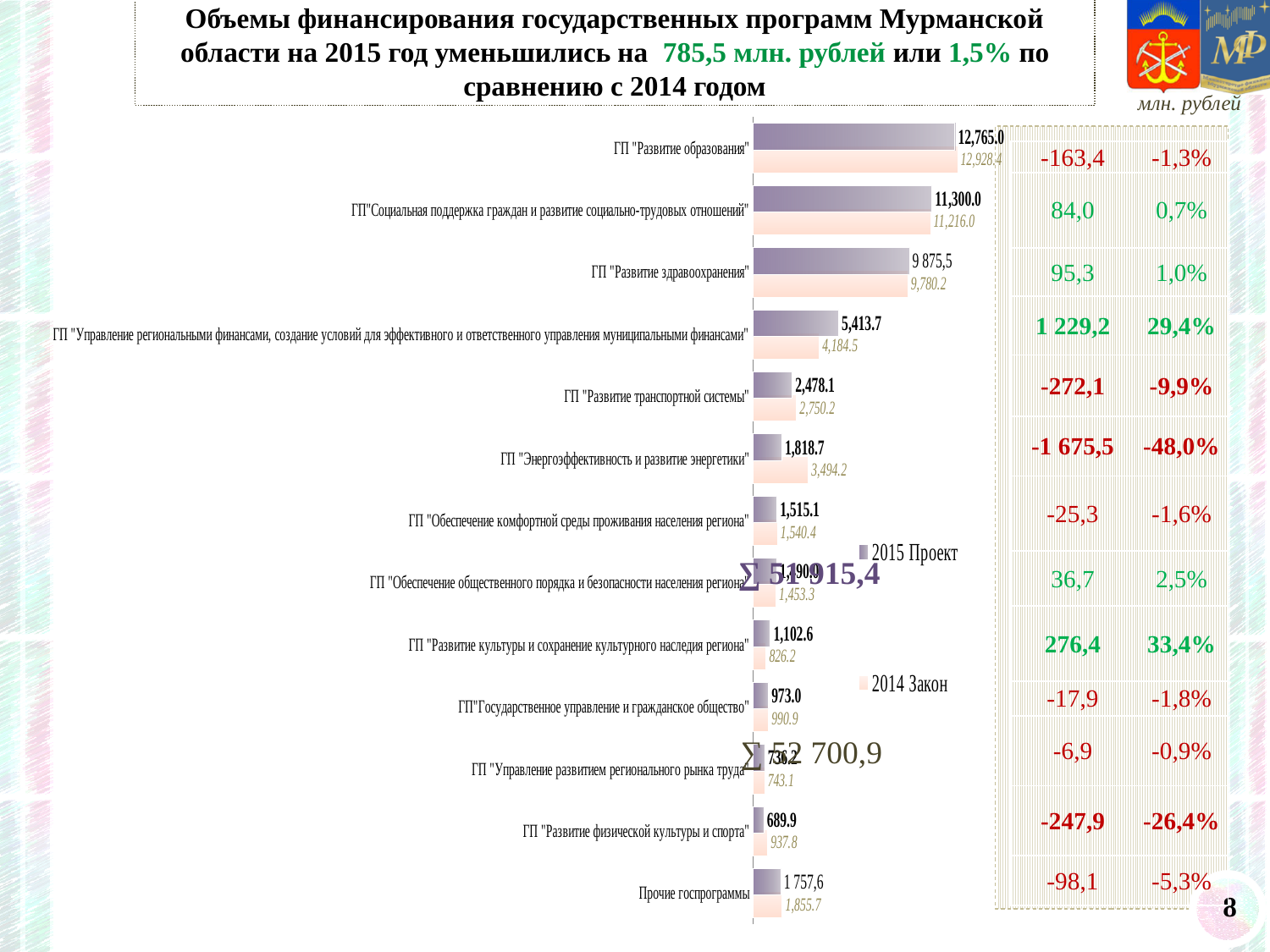
How many series does the chart legend list? 2 Which program has the highest 2015 Проект value? ГП "Развитие образования" What is the 2014 Закон value for ГП "Развитие здравоохранения"? 9,780.2 Which program has the lowest 2015 Проект value? ГП "Развитие физической культуры и спорта" What is the difference between the 2014 Закон and 2015 Проект values for ГП "Развитие образования"? 163.4 What is the 2014 Закон value for ГП "Развитие физической культуры и спорта"? 937.8 What is the 2015 Проект value for ГП "Развитие образования"? 12,765.0 What is the 2015 Проект value for ГП "Энергоэффективность и развитие энергетики"? 1,818.7 How many categories (programs) are plotted in the chart? 13 For ГП "Развитие транспортной системы", which is larger: the 2015 Проект value or the 2014 Закон value? 2014 Закон What are the two series named in the chart legend? 2015 Проект and 2014 Закон What kind of chart is shown on the slide? bar chart